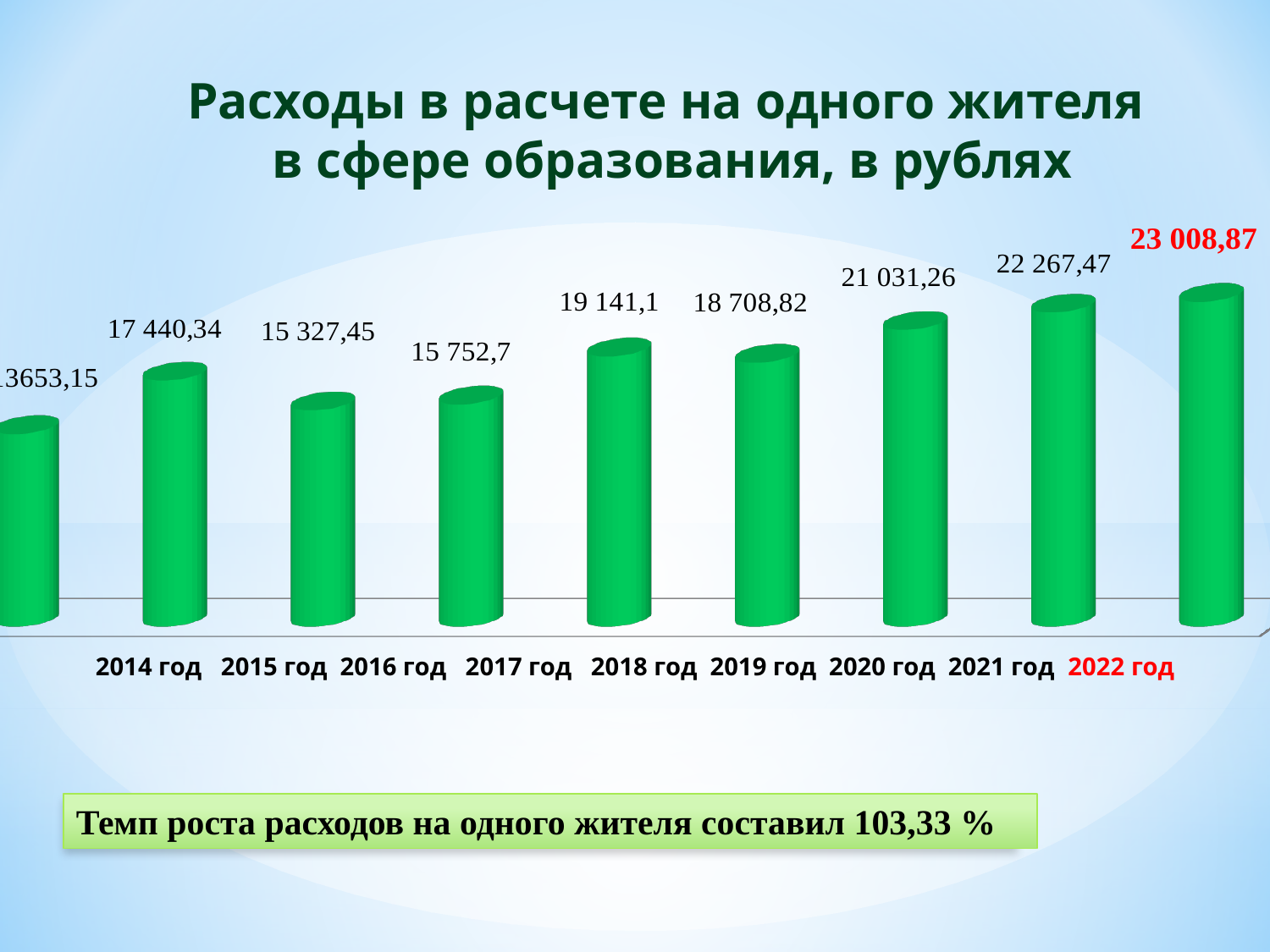
How many years are shown on the chart? 9 What is the difference between the values for 2018 год and 2019 год? 432,28 Which is larger, the value for 2017 год or the value for 2016 год? 2017 год Do the values generally rise or fall from 2014 год to 2022 год? Rise What kind of chart is shown on the slide? Bar chart What is the value for 2021 год? 22 267,47 What is the difference between the values for 2022 год and 2021 год? 741,4 What is the value for 2016 год? 15 327,45 What is the value for 2019 год? 18 708,82 What colour are the bars on the chart? Green Which year has the highest value? 2022 год Which year has the lowest value? 2014 год